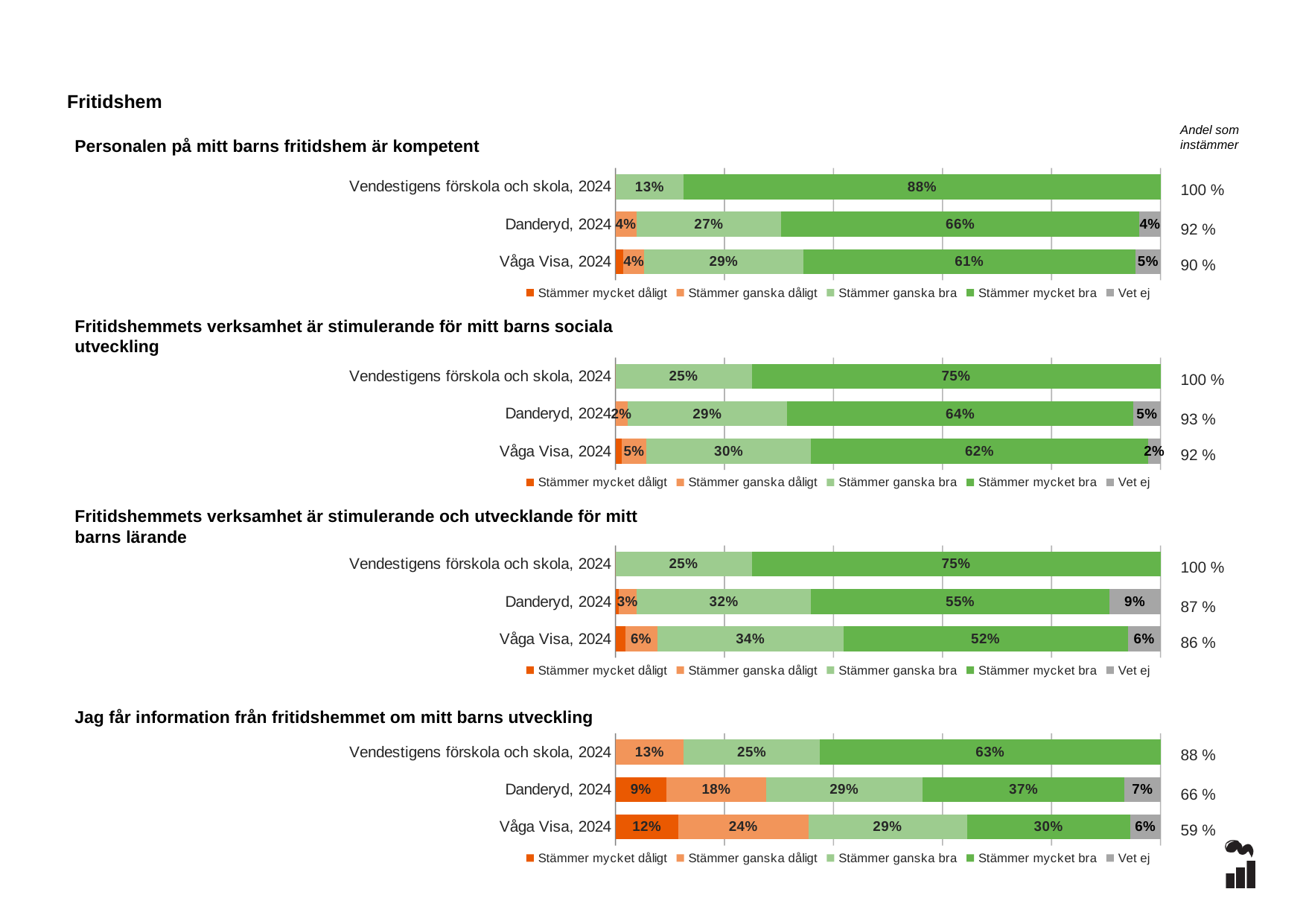
In the chart 'Fritidshemmets verksamhet är stimulerande och utvecklande för mitt barns lärande', what is the 'Vet ej' value for Danderyd, 2024? 9% In the chart 'Jag får information från fritidshemmet om mitt barns utveckling', which category has the lowest 'Stämmer mycket bra' value? Våga Visa, 2024 In the chart 'Personalen på mitt barns fritidshem är kompetent', what is the 'Stämmer mycket bra' value for Vendestigens förskola och skola, 2024? 88% In the chart 'Personalen på mitt barns fritidshem är kompetent', which category has the highest 'Stämmer mycket bra' value? Vendestigens förskola och skola, 2024 In the chart 'Personalen på mitt barns fritidshem är kompetent', what is the 'Stämmer ganska bra' value for Danderyd, 2024? 27% In the chart 'Fritidshemmets verksamhet är stimulerande för mitt barns sociala utveckling', what is the 'Stämmer mycket bra' value for Våga Visa, 2024? 62% In the chart 'Fritidshemmets verksamhet är stimulerande för mitt barns sociala utveckling', what is the difference between the 'Stämmer mycket bra' values for Vendestigens förskola och skola, 2024 and Danderyd, 2024? 11% What kind of chart is used for 'Jag får information från fritidshemmet om mitt barns utveckling'? Stacked bar chart In the chart 'Jag får information från fritidshemmet om mitt barns utveckling', what is the difference between the 'Stämmer ganska dåligt' values for Våga Visa, 2024 and Danderyd, 2024? 6% How many series does the legend list for the chart 'Personalen på mitt barns fritidshem är kompetent'? 5 In the chart 'Fritidshemmets verksamhet är stimulerande och utvecklande för mitt barns lärande', which is larger: the 'Stämmer ganska bra' value for Danderyd, 2024 or for Våga Visa, 2024? Våga Visa, 2024 In the chart 'Jag får information från fritidshemmet om mitt barns utveckling', what is the 'Stämmer mycket dåligt' value for Våga Visa, 2024? 12%